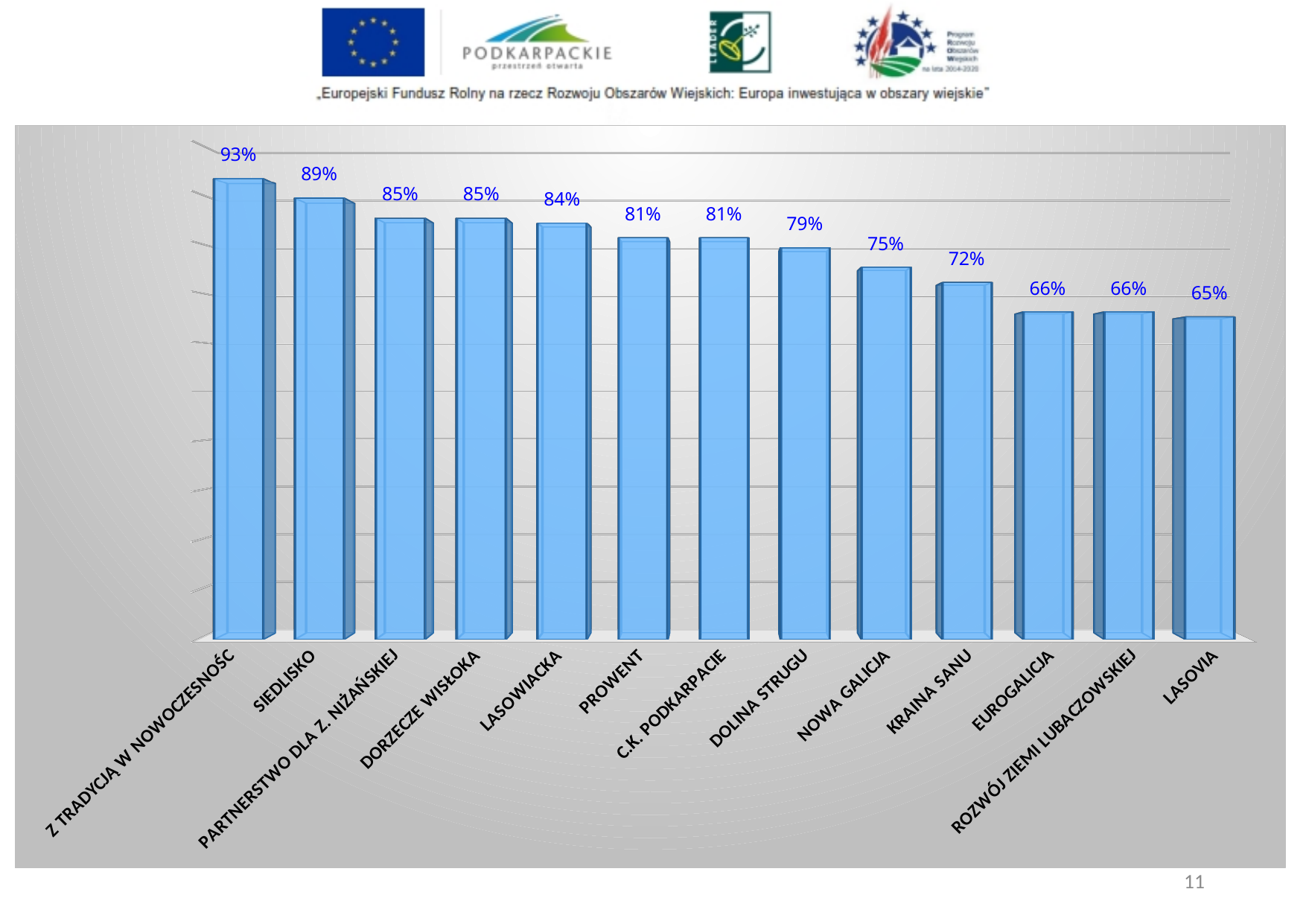
Which category has the lowest value? LASOVIA How many categories are shown on the chart? 13 What is the difference between the values for PROWENT and NOWA GALICJA? 6% What is the value for KRAINA SANU? 72% What kind of chart is shown on the slide? bar chart What colour are the bars on the chart? blue What is the value for DOLINA STRUGU? 79% Which is larger, the value for LASOWIACKA or the value for EUROGALICJA? LASOWIACKA Do the values rise or fall from left to right along the x axis? fall What is the difference between the values for Z TRADYCJĄ W NOWOCZESNOŚĆ and LASOVIA? 28% Which category has the highest value? Z TRADYCJĄ W NOWOCZESNOŚĆ What is the value for SIEDLISKO? 89%